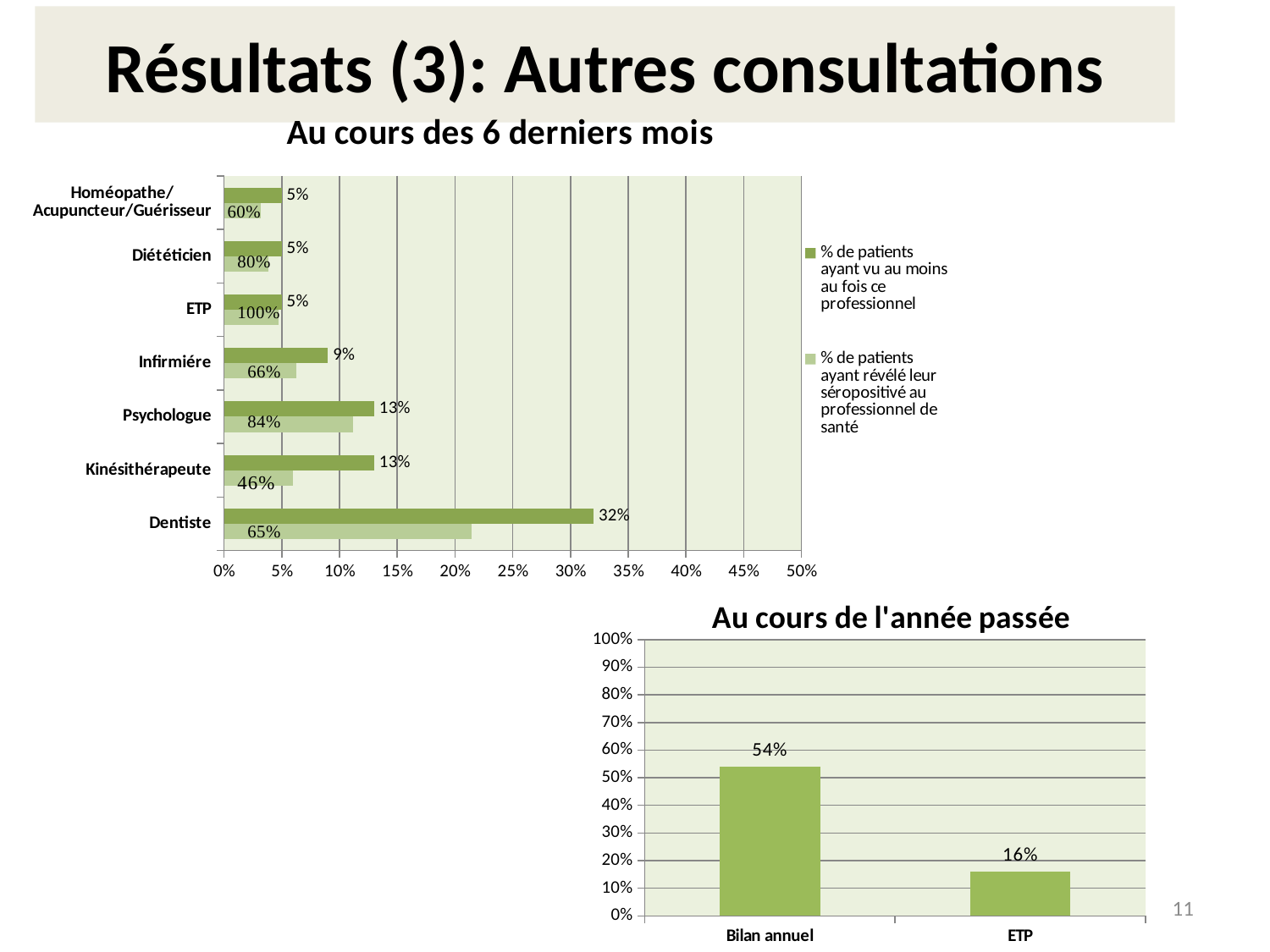
In the chart 'Au cours des 6 derniers mois', what is the value labelled on the dark green bar for Infirmiére? 9% In the chart 'Au cours des 6 derniers mois', what is the difference between the dark green values for Dentiste and Psychologue? 19% In the chart 'Au cours de l'année passée', what is the difference between Bilan annuel and ETP? 38% In the chart 'Au cours de l'année passée', what is the value for ETP? 16% In the chart 'Au cours des 6 derniers mois', which professional has the highest percentage of patients having seen them at least once? Dentiste What type of chart is 'Au cours de l'année passée'? Bar chart In the chart 'Au cours des 6 derniers mois', what percentage of patients saw a Dentiste at least once? 32% In the chart 'Au cours des 6 derniers mois', how many series does the legend list? 2 In the chart 'Au cours des 6 derniers mois', how many professional categories are listed on the vertical axis? 7 In the chart 'Au cours des 6 derniers mois', what value is labelled on the light green bar for Psychologue? 84% In the chart 'Au cours des 6 derniers mois', is the dark green value for Dentiste greater or less than 30%? greater In the chart 'Au cours de l'année passée', what is the value for Bilan annuel? 54%